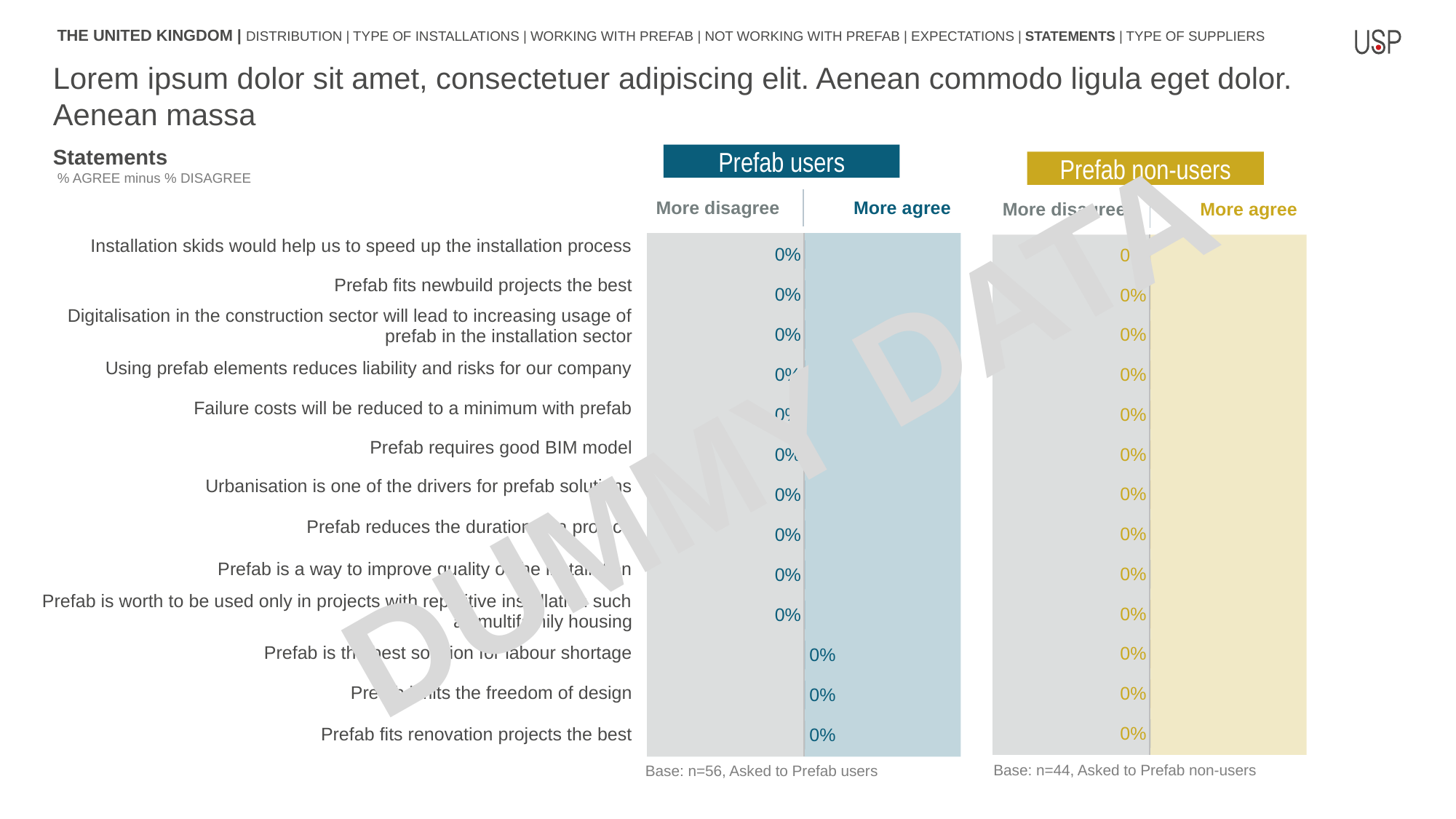
In the Prefab non-users chart, what is the value for 'Prefab fits renovation projects the best'? 0% What is the base (n) for the Prefab users chart? n=56 What is the difference between the Prefab users and Prefab non-users values for 'Prefab fits renovation projects the best'? 0% What measure do the charts show, according to the subtitle under 'Statements'? % AGREE minus % DISAGREE In the Prefab users chart, what is the value for 'Digitalisation in the construction sector will lead to increasing usage of prefab in the installation sector'? 0% In the Prefab non-users chart, what is the value for 'Prefab fits newbuild projects the best'? 0% In the Prefab users chart, what is the value for 'Prefab fits renovation projects the best'? 0% How many statements are listed in the charts? 13 In the Prefab users chart, what is the value for 'Prefab fits newbuild projects the best'? 0% In the Prefab users chart, what is the value for 'Installation skids would help us to speed up the installation process'? 0% In the Prefab non-users chart, what is the value for 'Prefab requires good BIM model'? 0%